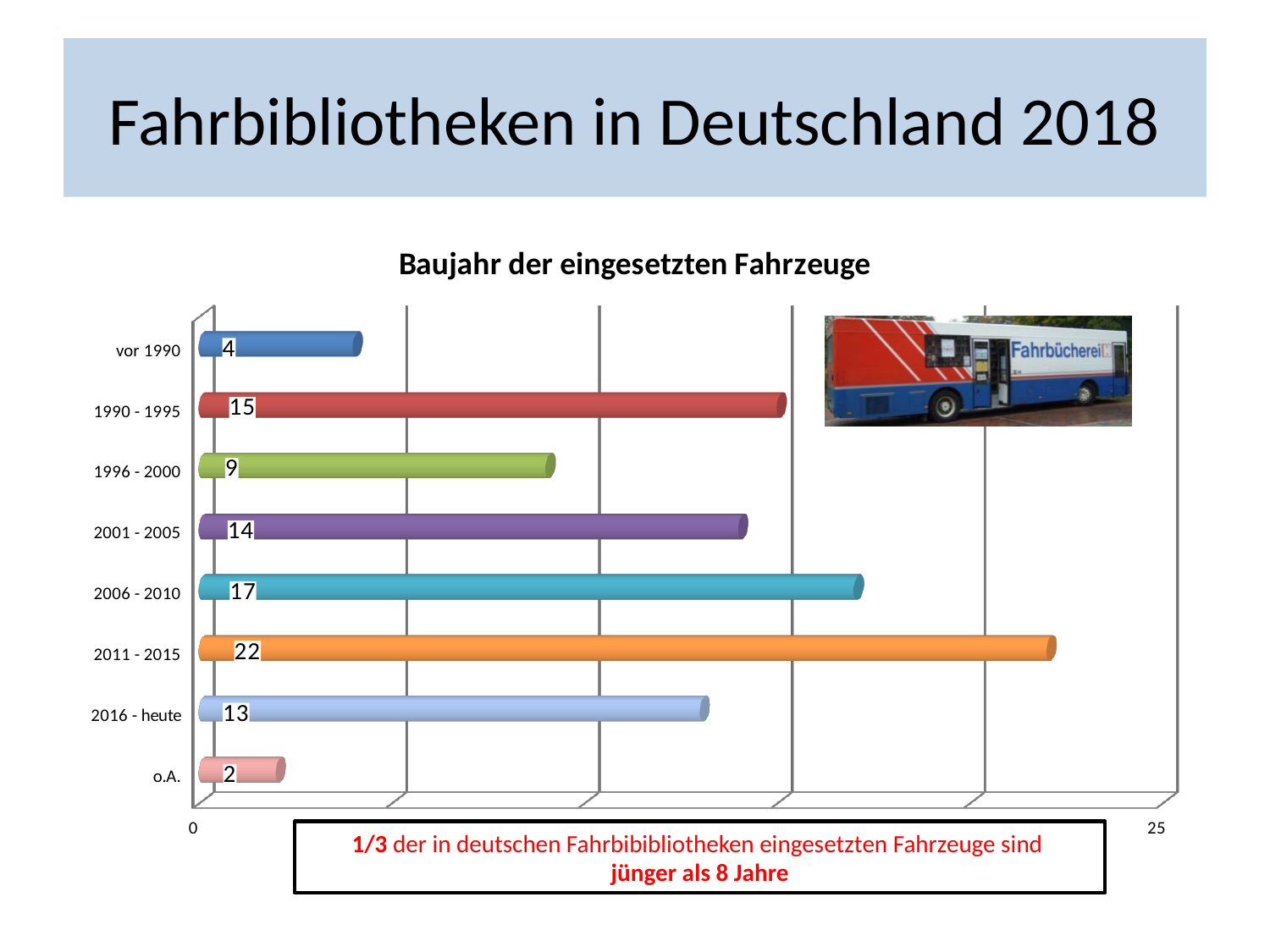
What is the difference between the values for '2011 - 2015' and '2006 - 2010'? 5 What is the title of the chart? Baujahr der eingesetzten Fahrzeuge Which category has the lowest value? o.A. What is the maximum value shown on the horizontal axis? 25 Which category has the highest value? 2011 - 2015 How many categories are shown in the chart? 8 What kind of chart is shown on the slide? bar chart What is the difference between the values for '1996 - 2000' and 'o.A.'? 7 Which is larger, the value for '1990 - 1995' or the value for '2001 - 2005'? 1990 - 1995 What is the value for the category 'vor 1990'? 4 What is the value for the category '2011 - 2015'? 22 What is the value for the category '2016 - heute'? 13